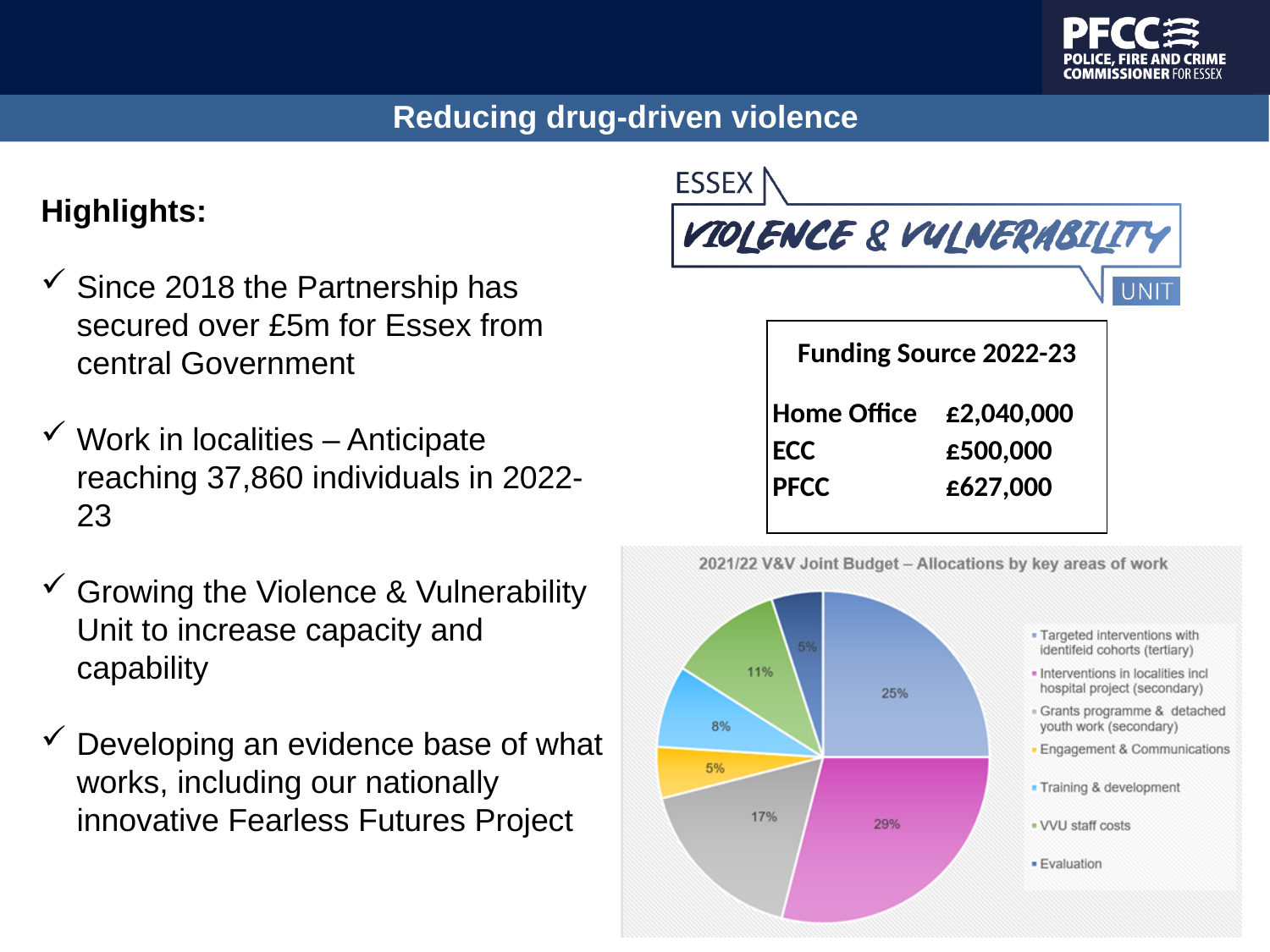
What percentage of the budget is allocated to VVU staff costs? 11% What is the difference in percentage points between the Interventions in localities slice and the Targeted interventions slice? 4 percentage points What is the title of the chart on the slide? 2021/22 V&V Joint Budget – Allocations by key areas of work Which area of work receives the largest share of the 2021/22 V&V Joint Budget? Interventions in localities incl hospital project (secondary) What share of the budget is allocated to Targeted interventions with identified cohorts (tertiary)? 25% What colour is the slice representing Engagement & Communications? Yellow What percentage of the budget is allocated to Training & development? 8% What share of the budget is allocated to Interventions in localities incl hospital project (secondary)? 29% Which is larger: the share for Grants programme & detached youth work or the share for VVU staff costs? Grants programme & detached youth work How many categories does the pie chart's legend list? 7 What share of the budget goes to Grants programme & detached youth work (secondary)? 17% What kind of chart is shown on the slide? Pie chart